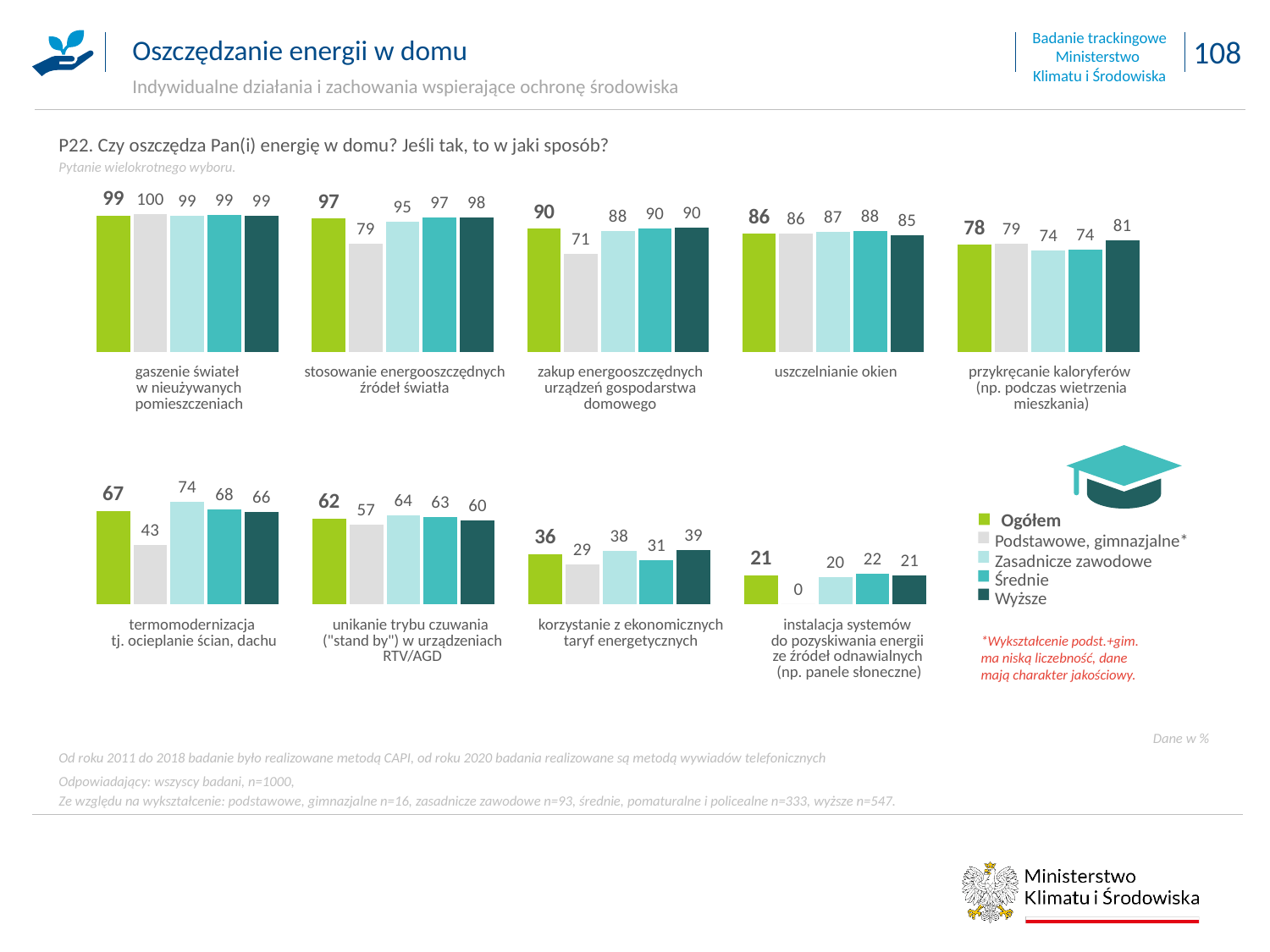
In the chart for "zakup energooszczędnych urządzeń gospodarstwa domowego", which education group has the lowest value? Podstawowe, gimnazjalne In the chart for "gaszenie świateł w nieużywanych pomieszczeniach", what is the value for Ogółem? 99 In the chart for "unikanie trybu czuwania ("stand by") w urządzeniach RTV/AGD", what is the value for Ogółem? 62 In the chart for "korzystanie z ekonomicznych taryf energetycznych", which is larger: the value for Wyższe or the value for Średnie? Wyższe How many education groups does the legend list? 4 In the chart for "stosowanie energooszczędnych źródeł światła", what is the value for Podstawowe, gimnazjalne? 79 Which colour represents Ogółem in the legend? Green In the chart for "przykręcanie kaloryferów", what is the value for Wyższe? 81 In the chart for "termomodernizacja tj. ocieplanie ścian, dachu", what is the difference between the Zasadnicze zawodowe value and the Podstawowe, gimnazjalne value? 31 In the chart for "termomodernizacja tj. ocieplanie ścian, dachu", which education group has the highest value? Zasadnicze zawodowe What kind of chart is used for "uszczelnianie okien"? Bar chart In the chart for "instalacja systemów do pozyskiwania energii ze źródeł odnawialnych", what is the value for Podstawowe, gimnazjalne? 0